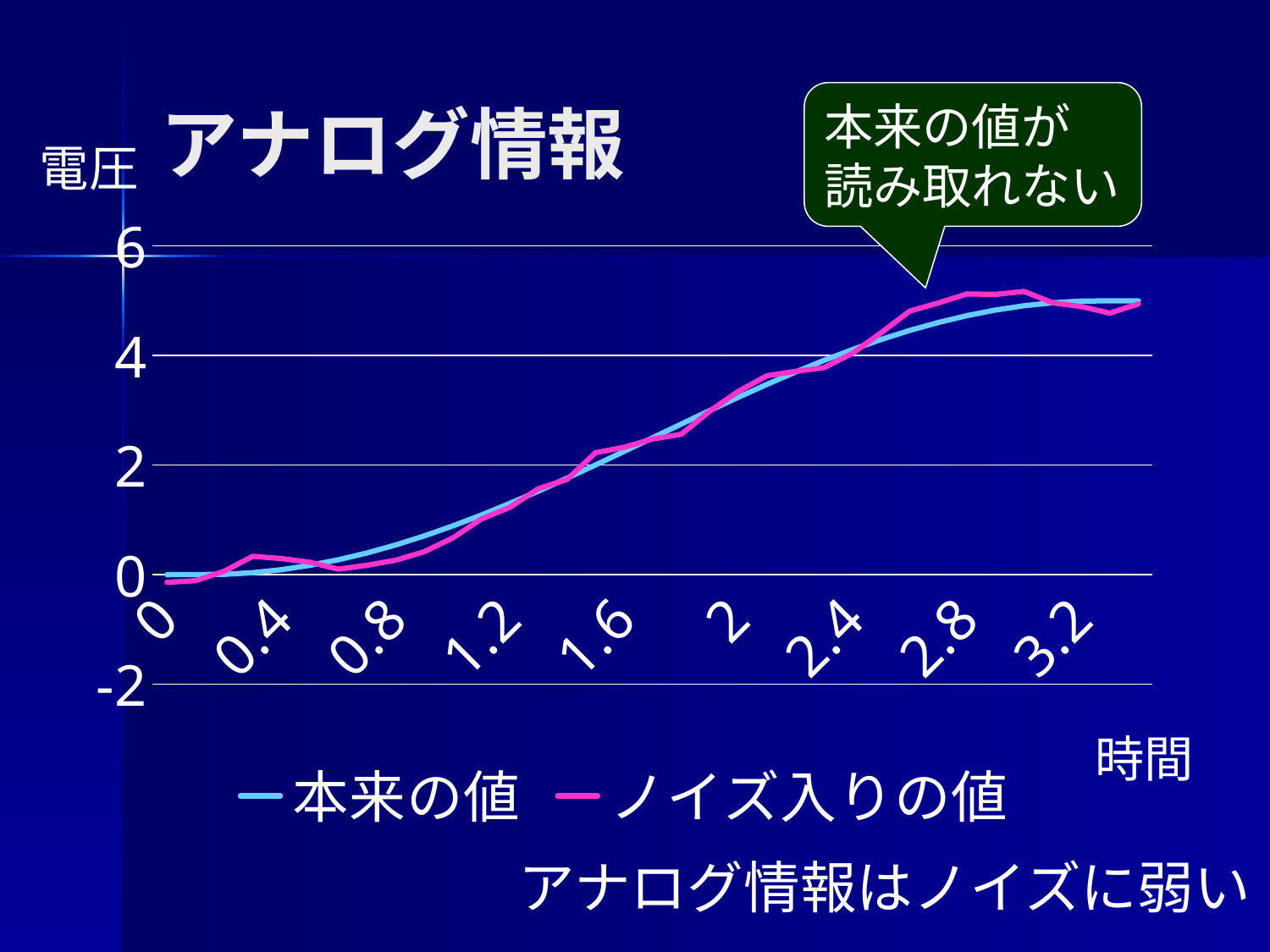
How many labeled tick marks are shown on the x axis? 9 Is the value of 本来の値 at time 2 greater or less than 2? greater What is the highest value labeled on the y axis? 6 Is the value of 本来の値 at time 0.8 greater or less than 2? less Is the value of 本来の値 at time 3.2 greater or less than 4? greater Do the values of 本来の値 rise or fall as time increases along the x axis? rise What is the title of the chart? アナログ情報 Which series is drawn in pink? ノイズ入りの値 What kind of chart is shown on the slide? line chart How many series does the legend list? 2